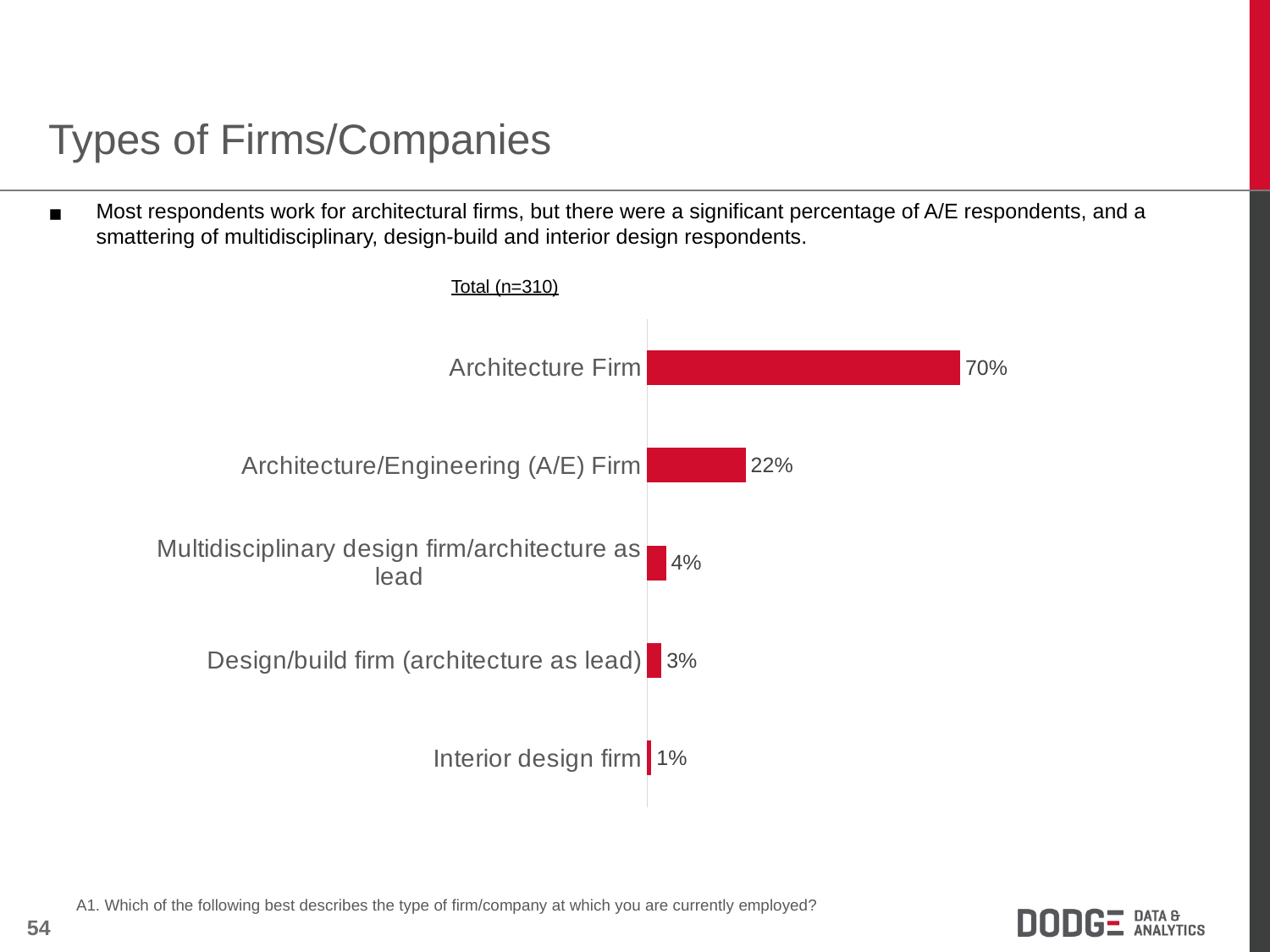
Which has a larger share of respondents: Multidisciplinary design firm/architecture as lead or Design/build firm (architecture as lead)? Multidisciplinary design firm/architecture as lead What percentage of respondents work for an Architecture Firm? 70% What is the value shown for Design/build firm (architecture as lead)? 3% What is the difference in percentage points between Architecture Firm and Architecture/Engineering (A/E) Firm? 48 What is the value shown for Interior design firm? 1% Which firm type has the highest percentage of respondents? Architecture Firm What is the sample size (n) shown above the chart? 310 What type of chart is used on this slide? Bar chart How many firm types are shown in the chart? 5 What colour are the bars in the chart? Red What percentage of respondents work for an Architecture/Engineering (A/E) Firm? 22% Which firm type has the lowest percentage of respondents? Interior design firm